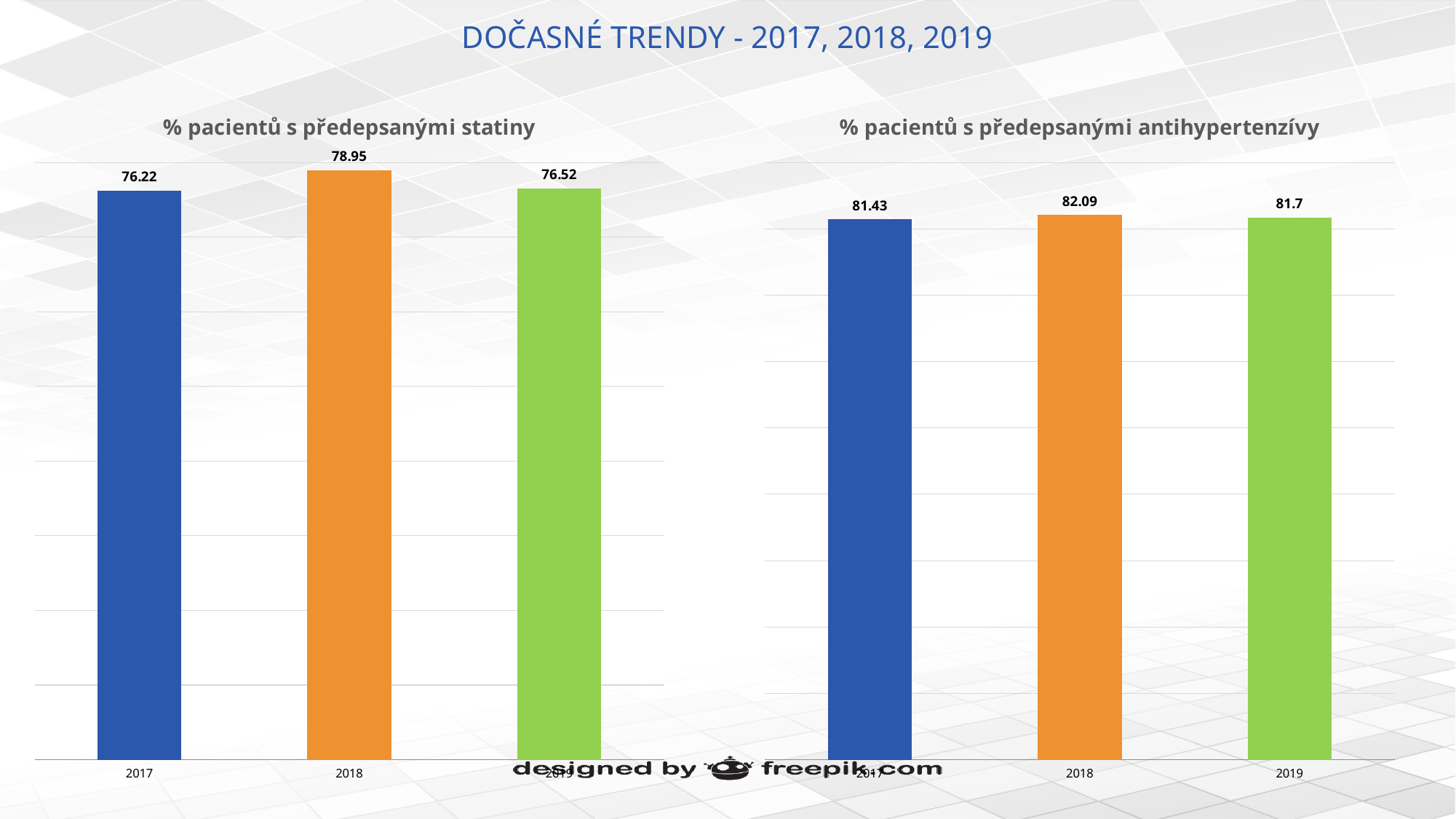
In the chart titled "% pacientů s předepsanými antihypertenzívy", what is the value for 2017? 81.43 In the chart titled "% pacientů s předepsanými statiny", what is the value for 2017? 76.22 What type of chart is the chart titled "% pacientů s předepsanými statiny"? Bar chart What is the main title at the top of the slide? DOČASNÉ TRENDY - 2017, 2018, 2019 In the chart titled "% pacientů s předepsanými statiny", what is the difference between the values for 2018 and 2017? 2.73 In the chart titled "% pacientů s předepsanými statiny", what is the value for 2018? 78.95 In the chart titled "% pacientů s předepsanými antihypertenzívy", what is the difference between the values for 2018 and 2019? 0.39 In the chart titled "% pacientů s předepsanými statiny", which is larger, the value for 2017 or the value for 2019? 2019 In the chart titled "% pacientů s předepsanými antihypertenzívy", which year has the lowest value? 2017 How many bars are shown in the chart titled "% pacientů s předepsanými antihypertenzívy"? 3 In the chart titled "% pacientů s předepsanými antihypertenzívy", what is the value for 2019? 81.7 In the chart titled "% pacientů s předepsanými statiny", which year has the highest value? 2018